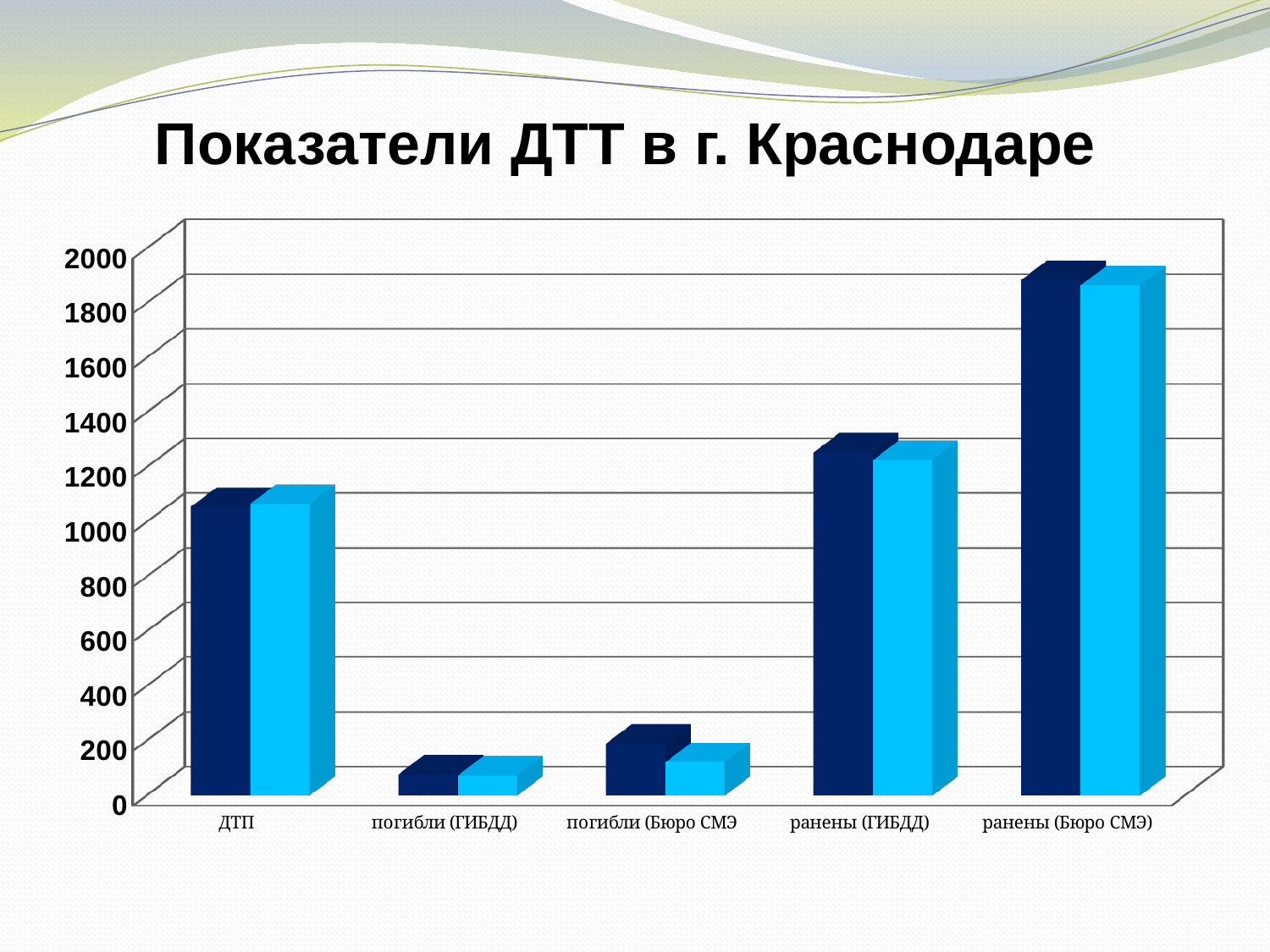
Which category has the lowest bars? погибли (ГИБДД) Which is larger, the dark blue value for погибли (Бюро СМЭ) or for погибли (ГИБДД)? погибли (Бюро СМЭ) Which is larger, the dark blue value for ранены (ГИБДД) or for ДТП? ранены (ГИБДД) Which category has the highest bars? ранены (Бюро СМЭ) What kind of chart is shown on the slide? bar chart Is the dark blue value for погибли (ГИБДД) greater or less than 200? less How many bars are plotted for each category? 2 Is the dark blue value for ранены (Бюро СМЭ) greater or less than 1800? greater What is the title of the chart? Показатели ДТТ в г. Краснодаре Is the dark blue value for погибли (Бюро СМЭ) greater or less than 400? less How many categories are shown on the x axis? 5